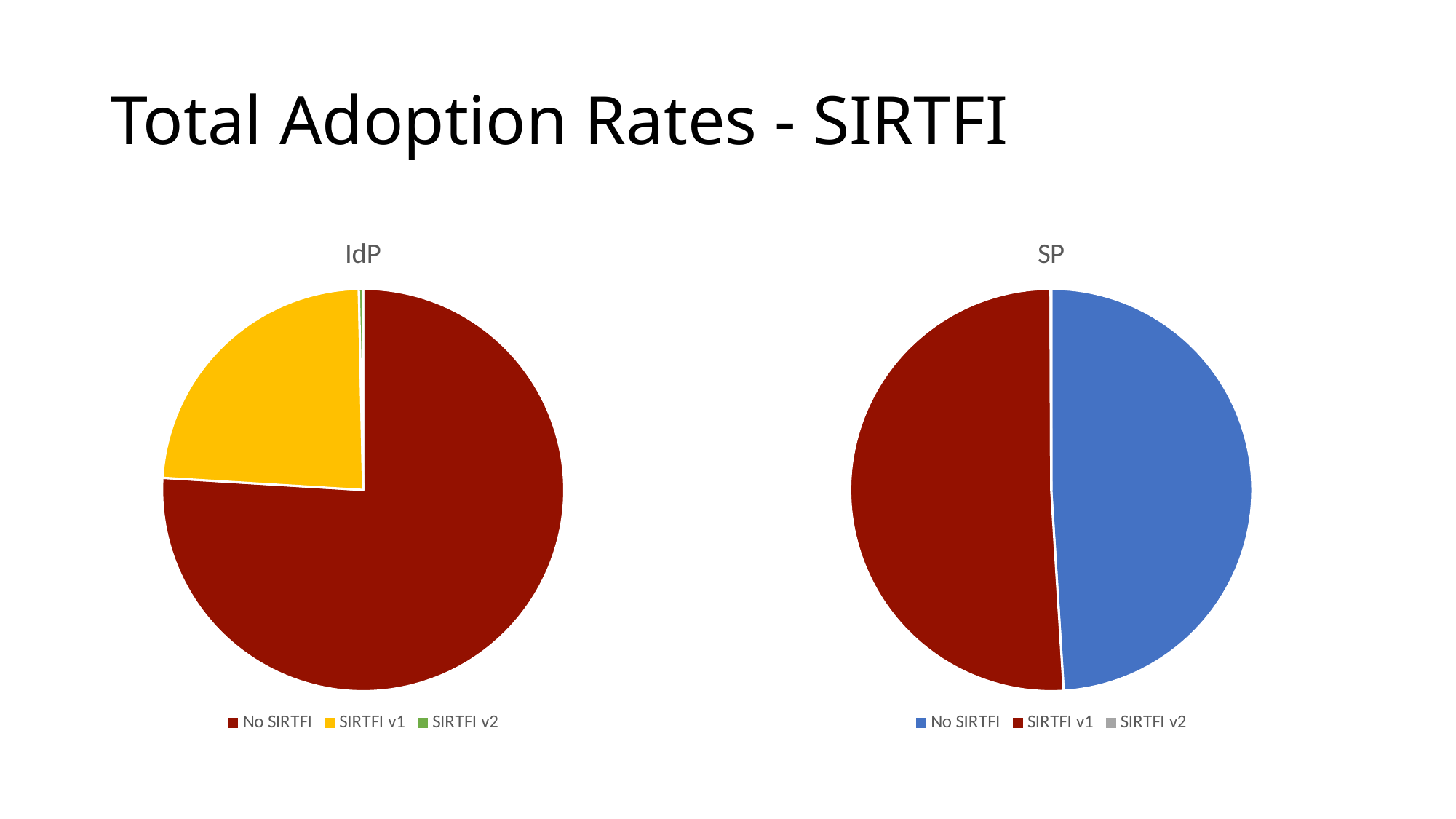
In the SP chart, which category has the smallest slice? SIRTFI v2 What is the title of the slide? Total Adoption Rates - SIRTFI In the IdP chart, which category has the smallest slice? SIRTFI v2 What kind of chart is the SP chart? Pie chart In the SP chart, what colour represents No SIRTFI? Blue How many categories does the legend of the IdP chart list? 3 How many categories does the legend of the SP chart list? 3 In the IdP chart, which category has the largest slice? No SIRTFI In the IdP chart, which slice is larger: No SIRTFI or SIRTFI v1? No SIRTFI In the SP chart, which slice is larger: No SIRTFI or SIRTFI v2? No SIRTFI In the IdP chart, which slice is larger: SIRTFI v1 or SIRTFI v2? SIRTFI v1 What kind of chart is the IdP chart? Pie chart